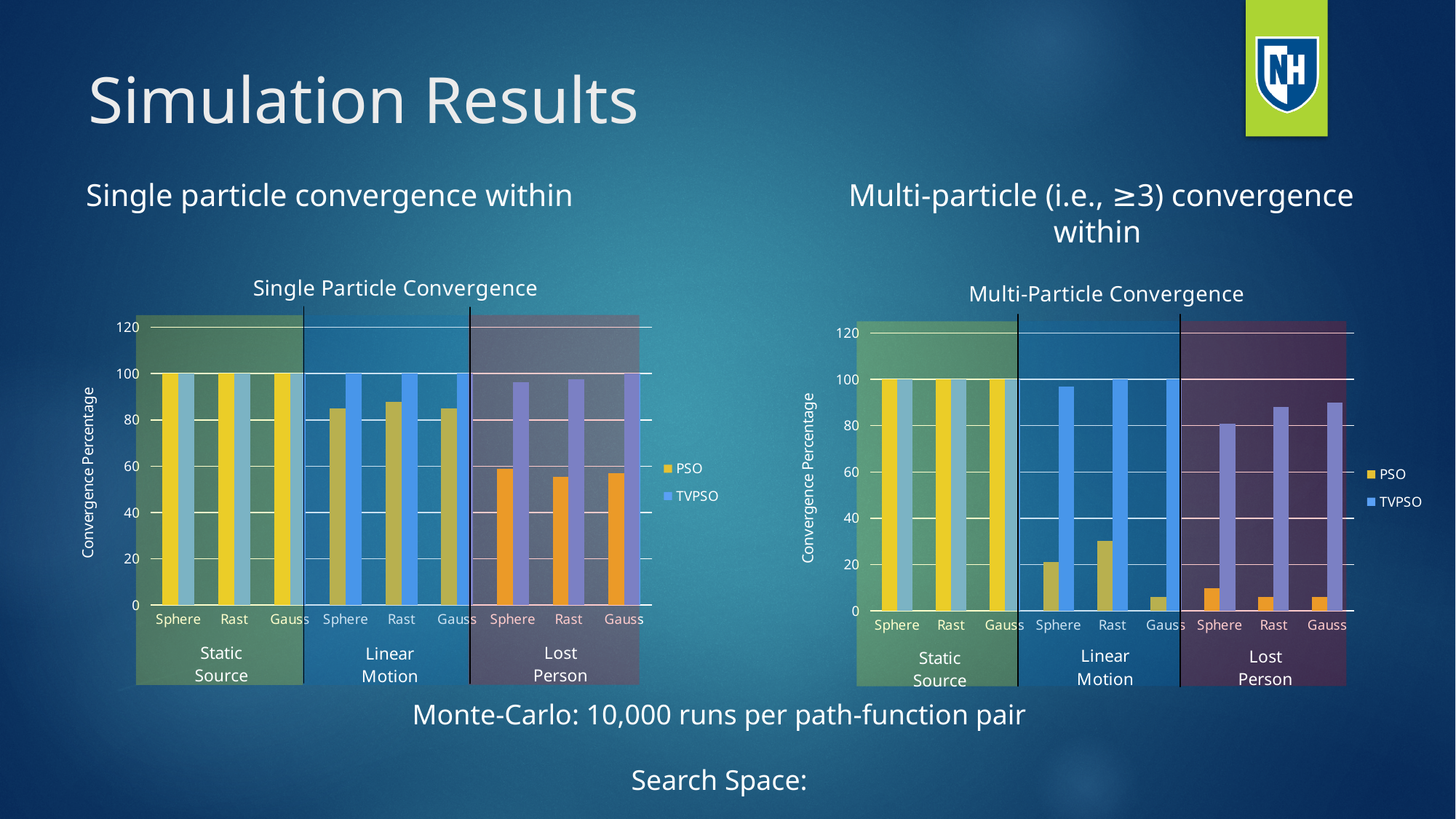
In the Multi-Particle Convergence chart, how many series does the legend list? 2 In the Multi-Particle Convergence chart, is the TVPSO value for Sphere under Lost Person greater or less than 60? greater In the Single Particle Convergence chart, what kind of chart is shown? bar chart In the Multi-Particle Convergence chart, which is larger under Linear Motion for Rast: PSO or TVPSO? TVPSO In the Single Particle Convergence chart, which scenario group has the lowest PSO values: Static Source, Linear Motion, or Lost Person? Lost Person In the Single Particle Convergence chart, is the PSO value for Rast under Lost Person greater or less than 60? less In the Single Particle Convergence chart, is the PSO value for Rast under Linear Motion greater or less than 80? greater In the Single Particle Convergence chart, how many categories are shown along the x axis? 9 In the Multi-Particle Convergence chart, what is the label on the vertical axis? Convergence Percentage